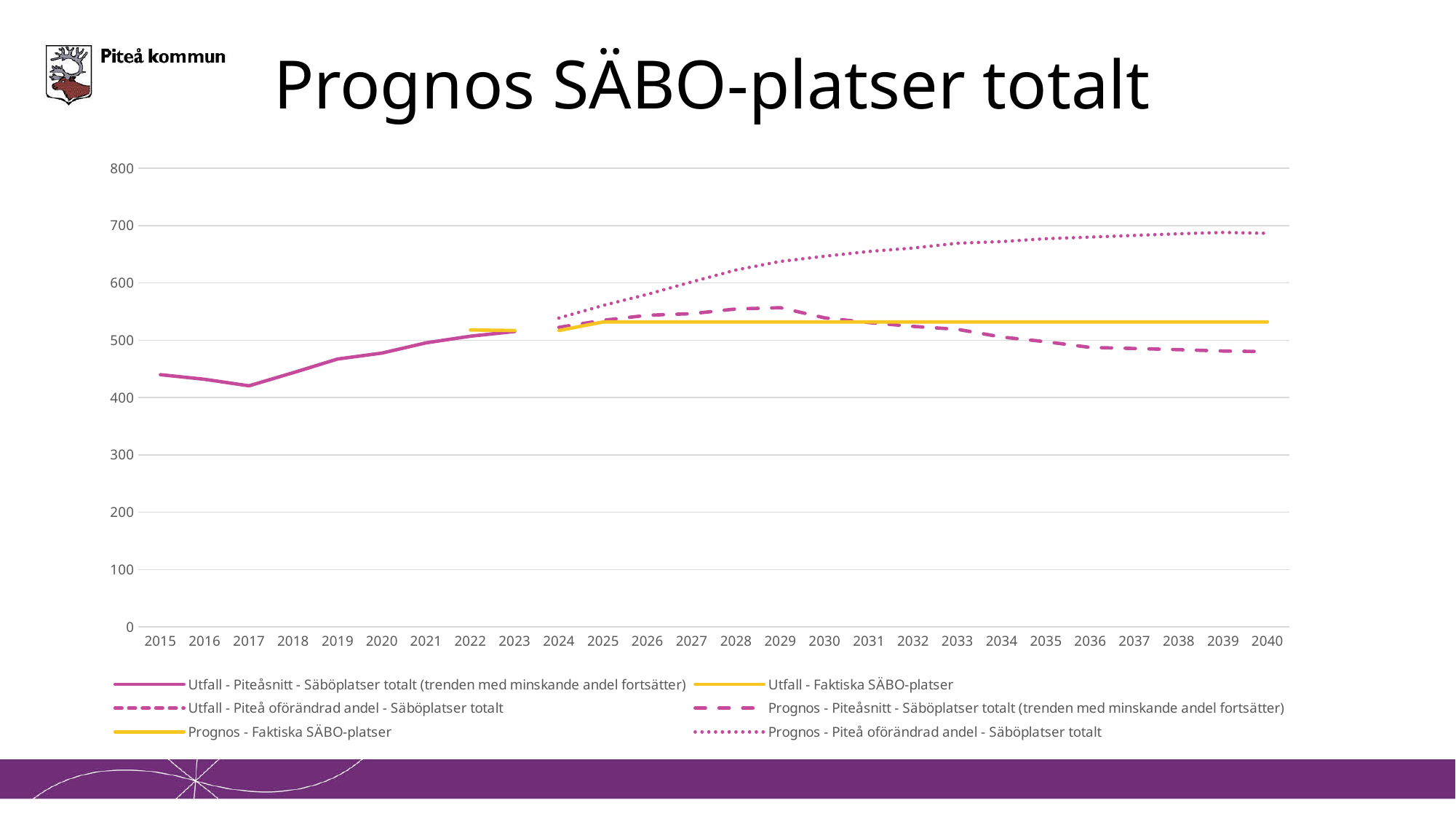
Is the value for 'Prognos - Faktiska SÄBO-platser' in 2040 greater or less than 500? greater Does the 'Prognos - Piteå oförändrad andel - Säböplatser totalt' series rise or fall from 2024 to 2040? Rise Does the 'Prognos - Piteåsnitt - Säböplatser totalt (trenden med minskande andel fortsätter)' series rise or fall from 2029 to 2040? Fall Is the value for 'Prognos - Piteå oförändrad andel - Säböplatser totalt' in 2040 greater or less than 600? greater How many years are shown on the x axis? 26 Which series has the lowest value in 2040? Prognos - Piteåsnitt - Säböplatser totalt (trenden med minskande andel fortsätter) Is the value for 'Utfall - Piteåsnitt - Säböplatser totalt (trenden med minskande andel fortsätter)' in 2017 greater or less than 500? less Which series has the highest value in 2040? Prognos - Piteå oförändrad andel - Säböplatser totalt What kind of chart is shown on the slide? Line chart How many series does the legend list? 6 What is the title of the chart? Prognos SÄBO-platser totalt